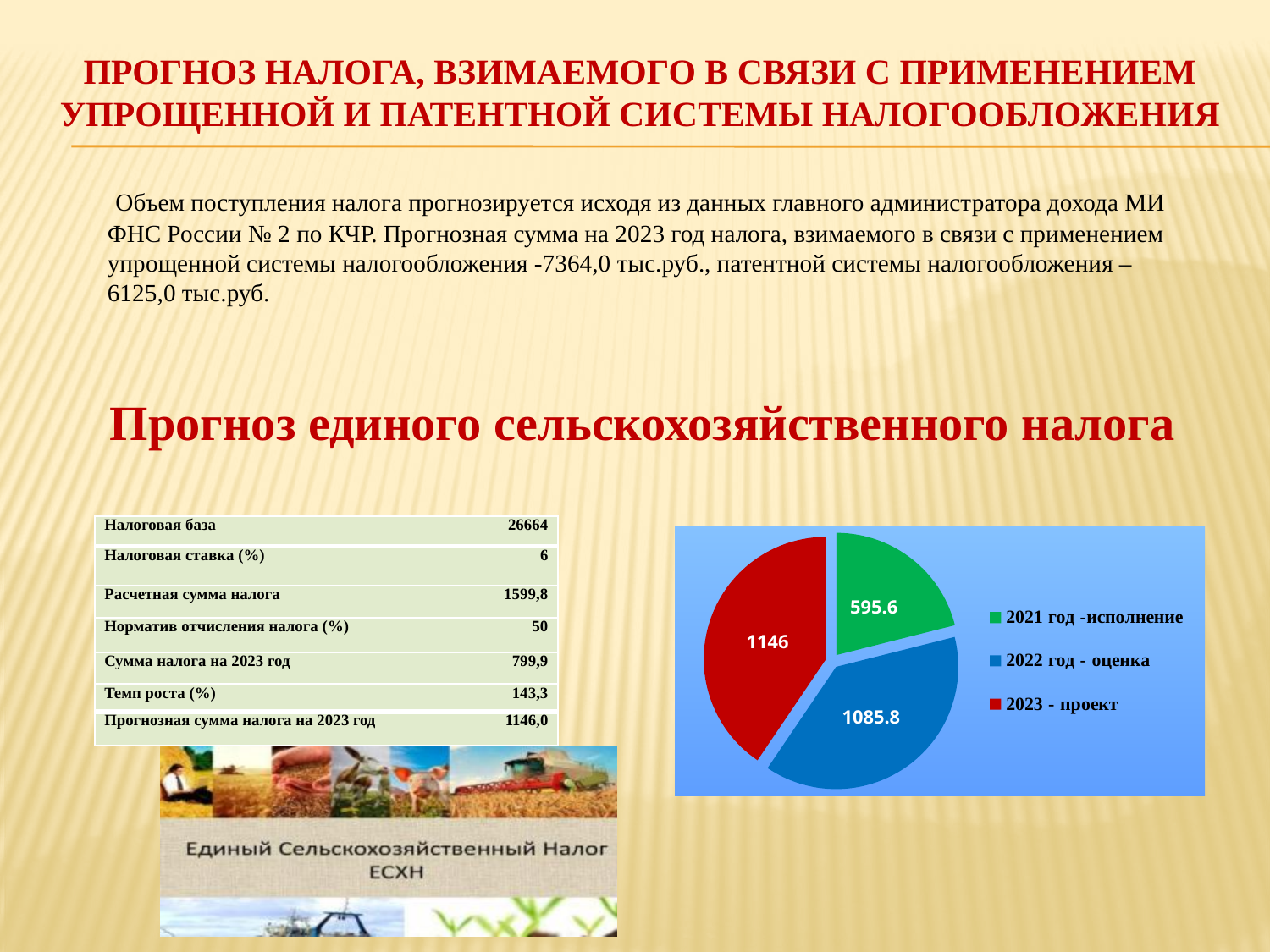
What is the difference between the values for "2022 год - оценка" and "2021 год -исполнение"? 490.2 What is the value for "2022 год - оценка" in the pie chart? 1085.8 What is the value for "2021 год -исполнение" in the pie chart? 595.6 What is the value for "2023 - проект" in the pie chart? 1146 How many slices does the pie chart have? 3 Which category has the smallest slice in the pie chart? 2021 год -исполнение What kind of chart is shown on the slide? pie chart Which category has the largest slice in the pie chart? 2023 - проект How many entries does the legend of the pie chart list? 3 Which is larger: the value for "2021 год -исполнение" or the value for "2022 год - оценка"? 2022 год - оценка What colour is the slice for "2023 - проект" in the pie chart? red What is the difference between the values for "2023 - проект" and "2022 год - оценка"? 60.2